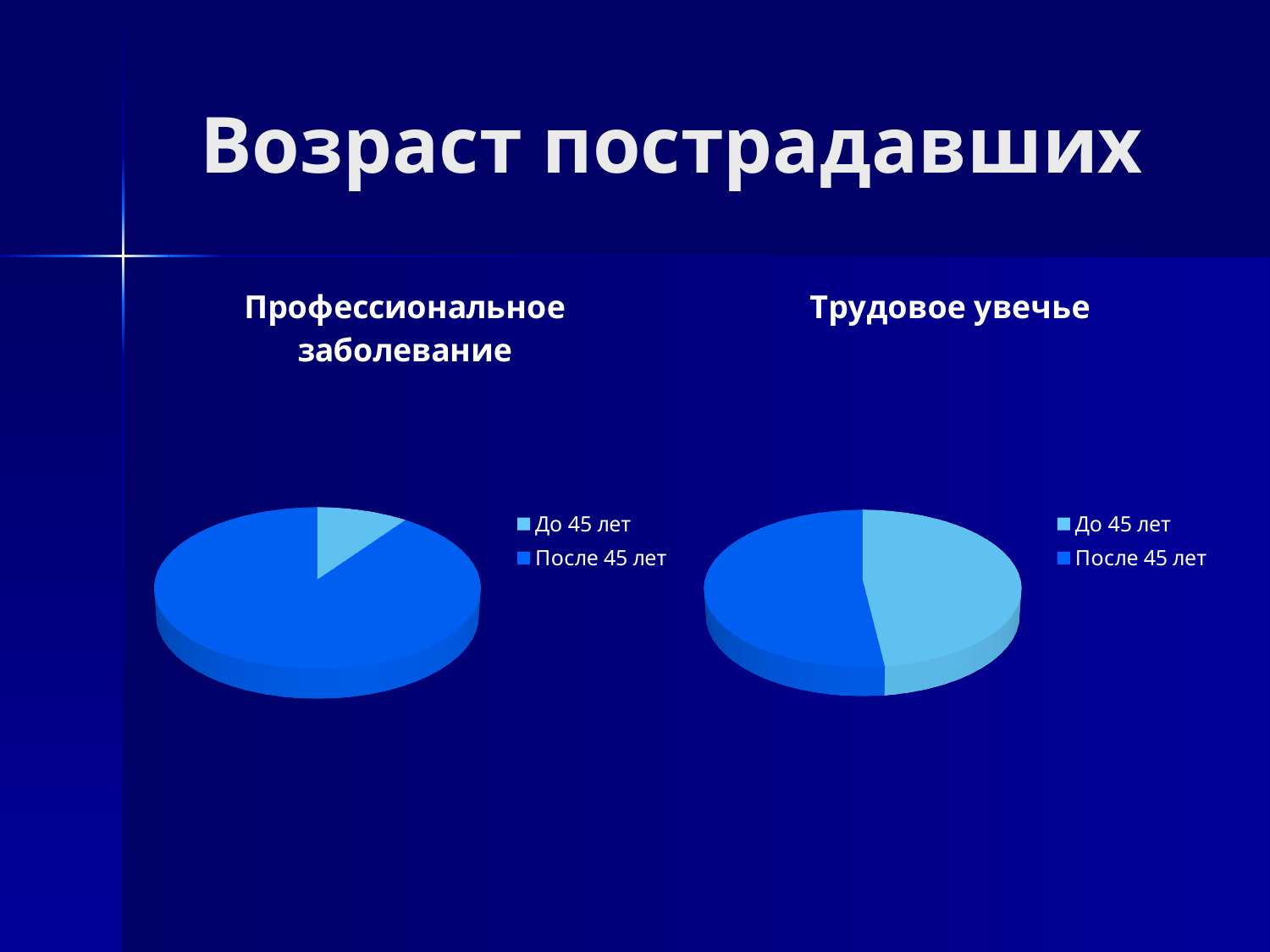
What is the title of the slide containing the two pie charts? Возраст пострадавших How many slices does the 'Трудовое увечье' pie chart have? 2 How many entries does the legend of the 'Профессиональное заболевание' chart list? 2 What kind of chart is the 'Профессиональное заболевание' chart? pie chart In the 'Профессиональное заболевание' chart, which slice is larger: 'До 45 лет' or 'После 45 лет'? После 45 лет What kind of chart is the 'Трудовое увечье' chart? pie chart How many pie charts are shown on the slide? 2 In the 'Профессиональное заболевание' chart, which category has the largest slice? После 45 лет In the 'Профессиональное заболевание' chart, which category has the smallest slice? До 45 лет What are the two legend entries of the 'Трудовое увечье' chart? До 45 лет, После 45 лет How many slices does the 'Профессиональное заболевание' pie chart have? 2